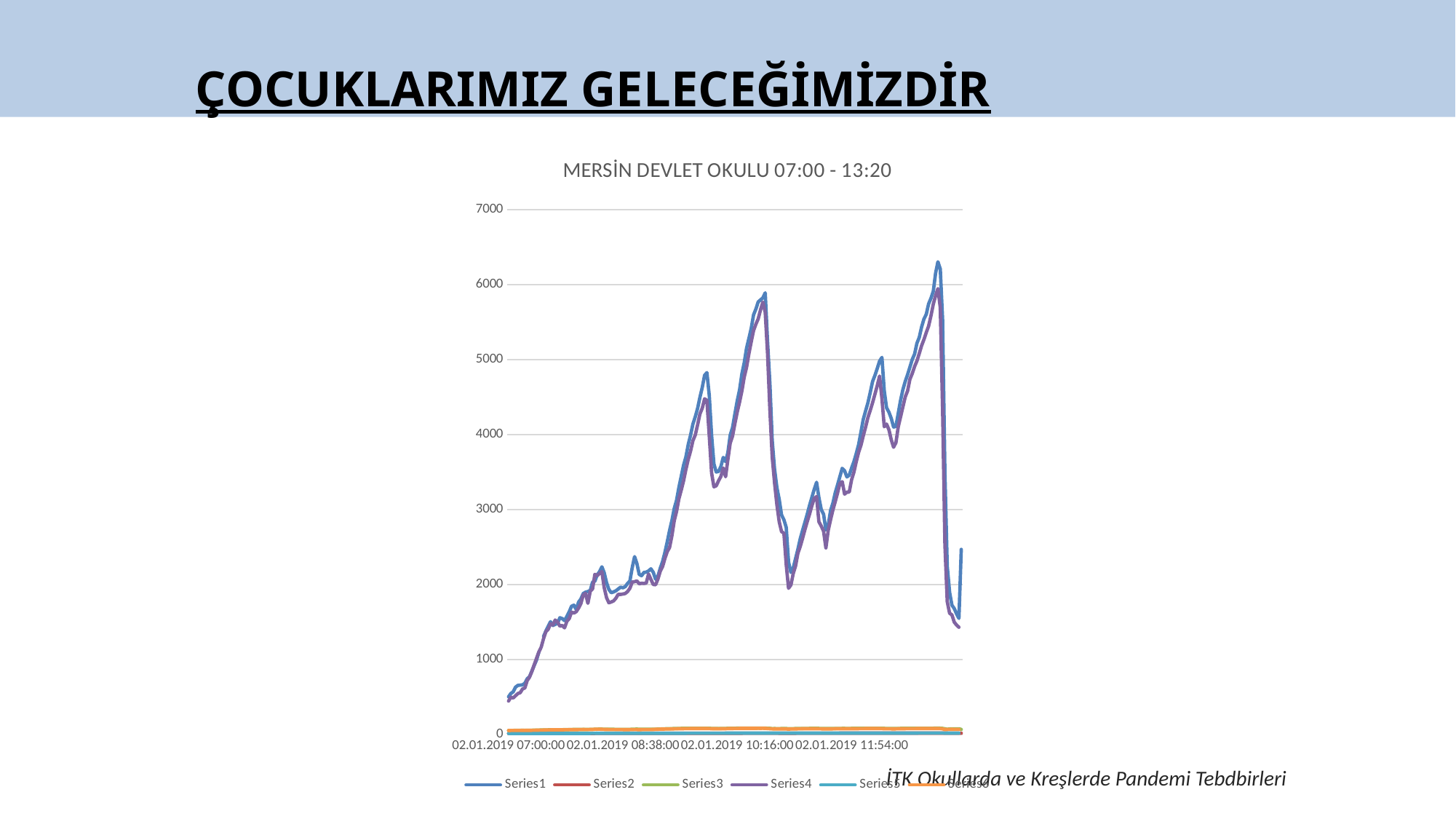
Are the values of Series2 greater or less than 1000 throughout the chart? less Is the peak value of Series4 greater or less than 5000? greater How many date-time labels are shown on the x axis? 4 Do the values of Series1 generally rise or fall from 07:00 up to the peak near the end of the chart? rise Is the peak value of Series1 greater or less than 6000? greater What is the title of the chart? MERSİN DEVLET OKULU 07:00 - 13:20 What is the highest value shown on the y axis? 7000 Which series has larger values, Series1 or Series2? Series1 How many series does the chart's legend list? 6 Which series reaches the highest value on the chart? Series1 What kind of chart is shown on the slide? line chart